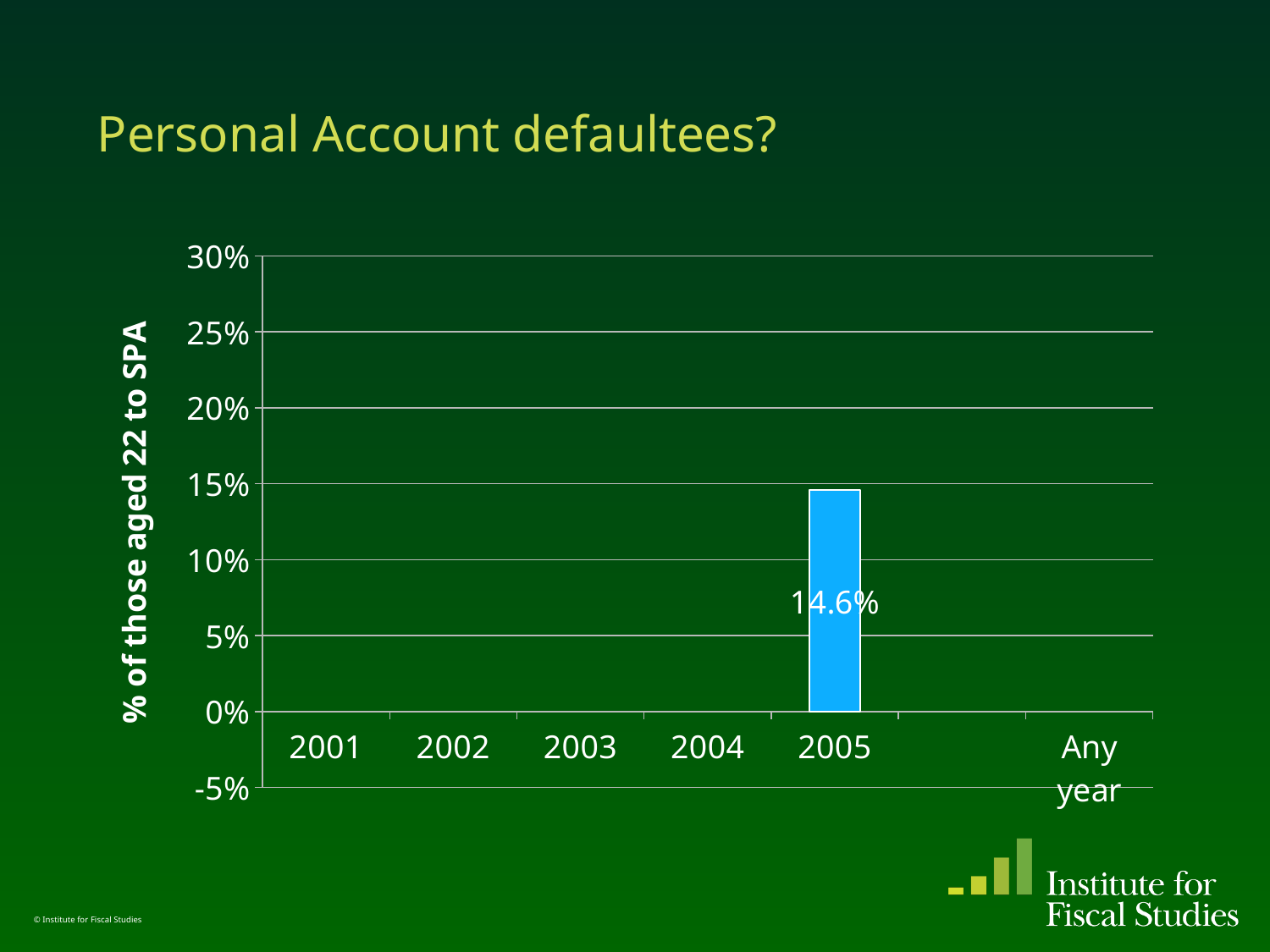
Which category has the highest plotted value? 2005 What is the value for 2005? 14.6% Is the value for 2005 greater or less than 15%? less How many categories are labelled on the x axis? 6 What is the title of the slide? Personal Account defaultees? Is the value for 2005 greater or less than 20%? less Is the value for 2005 greater or less than 10%? greater What is the label on the y axis? % of those aged 22 to SPA Which category is the only one with a bar plotted? 2005 What kind of chart is shown on the slide? bar chart